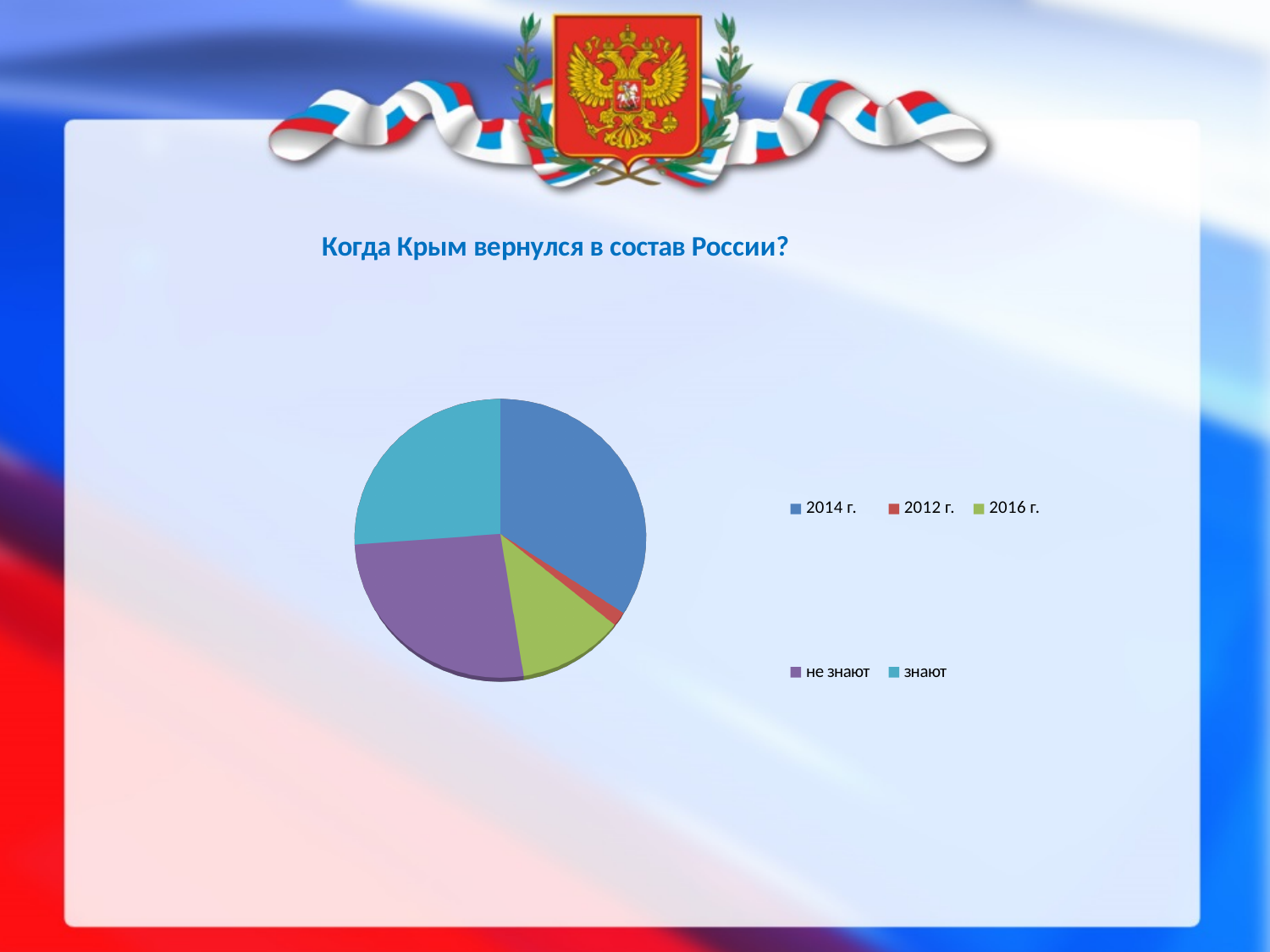
How many slices does the pie chart have? 5 What colour is the slice for 2012 г.? red Which slice is larger, знают or 2012 г.? знают Which slice is larger, 2014 г. or не знают? 2014 г. Which slice is larger, 2014 г. or 2016 г.? 2014 г. What is the title of the chart? Когда Крым вернулся в состав России? Which category has the largest slice of the pie? 2014 г. What kind of chart is shown on the slide? pie chart Which category has the smallest slice of the pie? 2012 г.